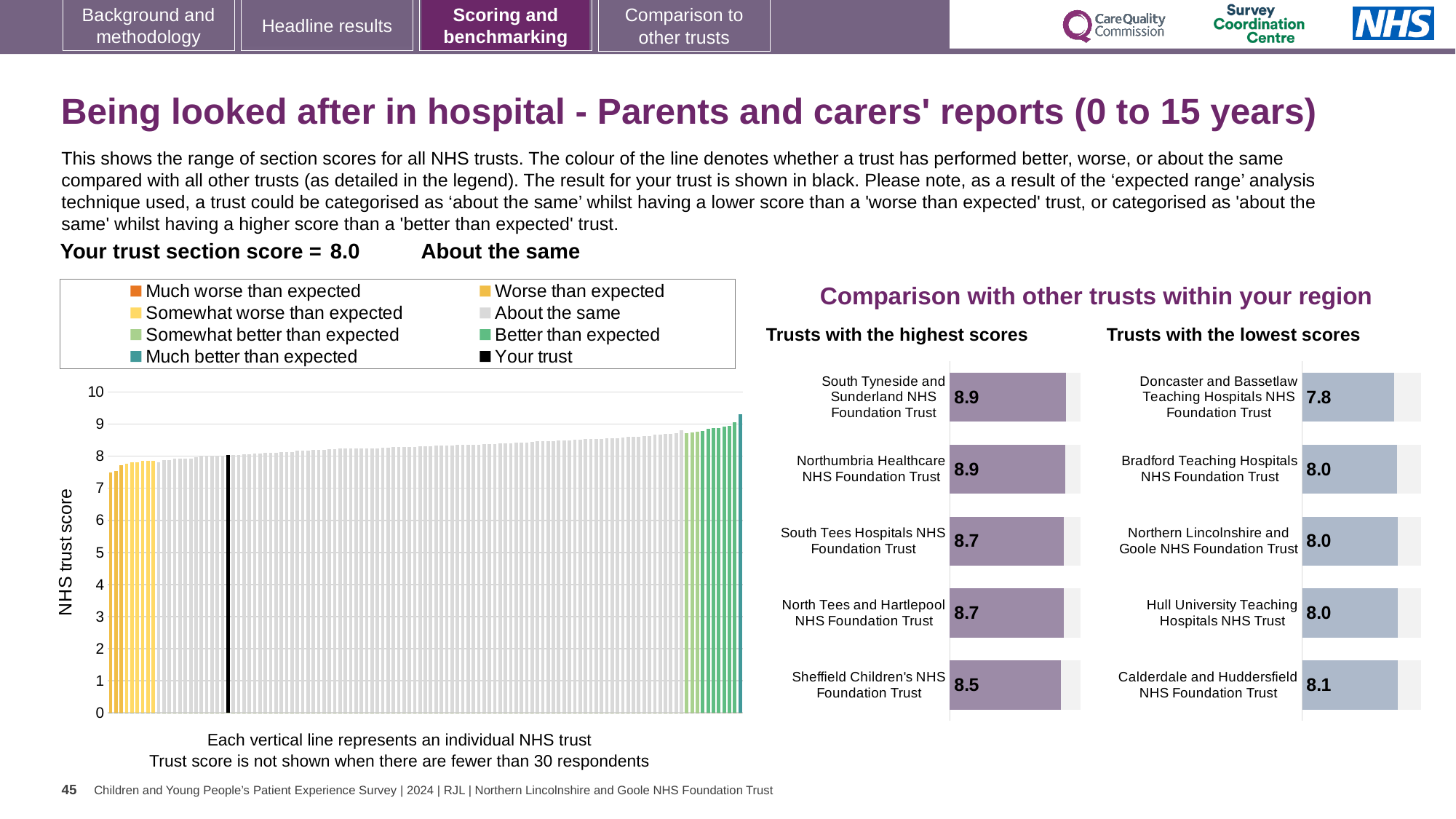
In the 'Trusts with the lowest scores' chart, which trust has the lowest score? Doncaster and Bassetlaw Teaching Hospitals NHS Foundation Trust How many trusts are shown in the 'Trusts with the lowest scores' chart? 5 In the 'Trusts with the lowest scores' chart, what is the difference between the scores of Calderdale and Huddersfield NHS Foundation Trust and Doncaster and Bassetlaw Teaching Hospitals NHS Foundation Trust? 0.3 In the 'Trusts with the highest scores' chart, what is the score for South Tees Hospitals NHS Foundation Trust? 8.7 In the 'Trusts with the highest scores' chart, what is the difference between the scores of South Tyneside and Sunderland NHS Foundation Trust and Sheffield Children's NHS Foundation Trust? 0.4 How many entries does the legend of the large chart on the left list? 8 In the 'Trusts with the highest scores' chart, which trust has the lowest score? Sheffield Children's NHS Foundation Trust In the 'Trusts with the lowest scores' chart, what is the score for Doncaster and Bassetlaw Teaching Hospitals NHS Foundation Trust? 7.8 In the 'Trusts with the highest scores' chart, which has the higher score: South Tees Hospitals NHS Foundation Trust or Sheffield Children's NHS Foundation Trust? South Tees Hospitals NHS Foundation Trust In the 'Trusts with the lowest scores' chart, which trust has the highest score? Calderdale and Huddersfield NHS Foundation Trust In the 'Trusts with the highest scores' chart, what is the score for Sheffield Children's NHS Foundation Trust? 8.5 In the large chart on the left, do the trust scores rise or fall from left to right along the x axis? rise